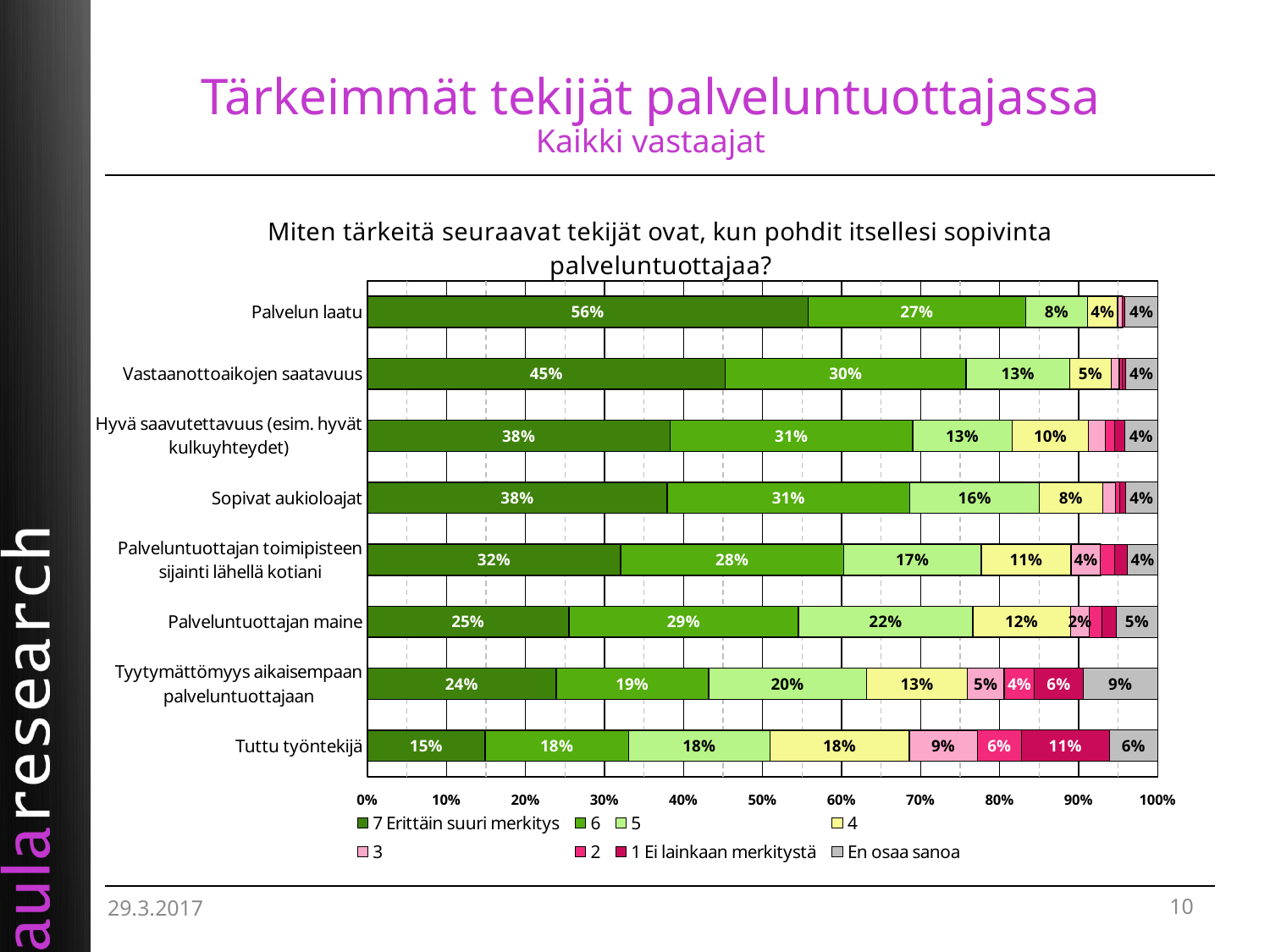
What type of chart is shown on the slide? Stacked bar chart Is the "7 Erittäin suuri merkitys" value for "Palvelun laatu" greater or less than 50%? greater What percentage of respondents rated "Palvelun laatu" as "7 Erittäin suuri merkitys"? 56% How many percentage points higher is the "7 Erittäin suuri merkitys" share for "Palvelun laatu" than for "Tuttu työntekijä"? 41 percentage points What is the "1 Ei lainkaan merkitystä" share for "Tuttu työntekijä"? 11% Which category has the highest share of "7 Erittäin suuri merkitys" responses? Palvelun laatu What is the value of series "5" for "Palveluntuottajan maine"? 22% Which category has the lowest share of "7 Erittäin suuri merkitys" responses? Tuttu työntekijä How many categories (factors) are shown in the chart? 8 How many series does the legend list? 8 Which has a larger value for series "6": "Vastaanottoaikojen saatavuus" or "Palvelun laatu"? Vastaanottoaikojen saatavuus What is the "En osaa sanoa" value for "Tyytymättömyys aikaisempaan palveluntuottajaan"? 9%